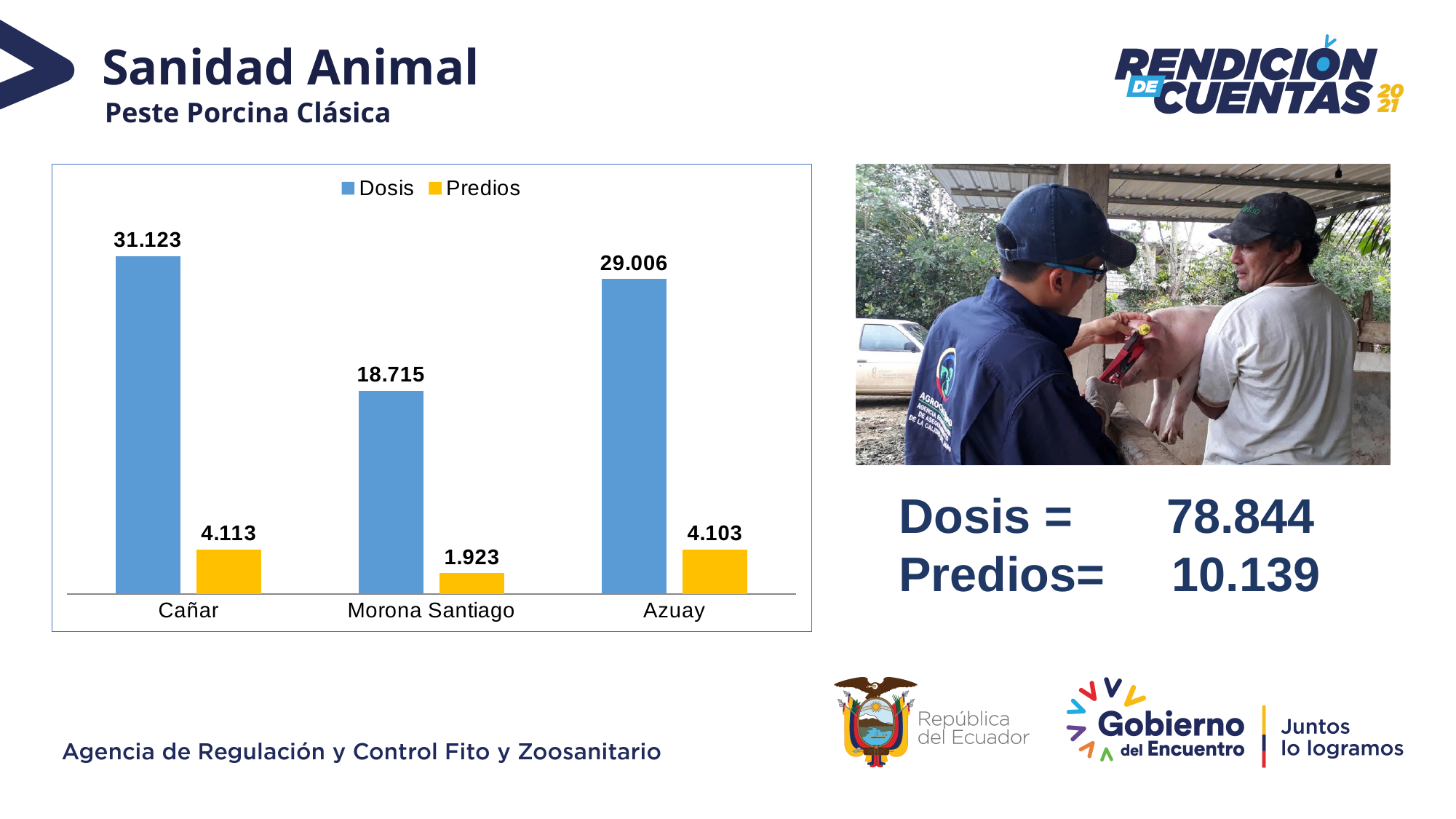
What is the difference between the Dosis values for Cañar and Morona Santiago? 12.408 What is the Dosis value for Cañar? 31.123 Which province has the lowest Predios value? Morona Santiago What is the Predios value for Azuay? 4.103 How many provinces are shown on the x axis of the chart? 3 What is the Dosis value for Azuay? 29.006 What is the Predios value for Morona Santiago? 1.923 What is the difference between the Predios values for Cañar and Morona Santiago? 2.190 Which is larger, the Dosis value for Cañar or for Azuay? Cañar Which province has the lowest Dosis value? Morona Santiago How many series does the chart legend list? 2 Which province has the highest Dosis value? Cañar